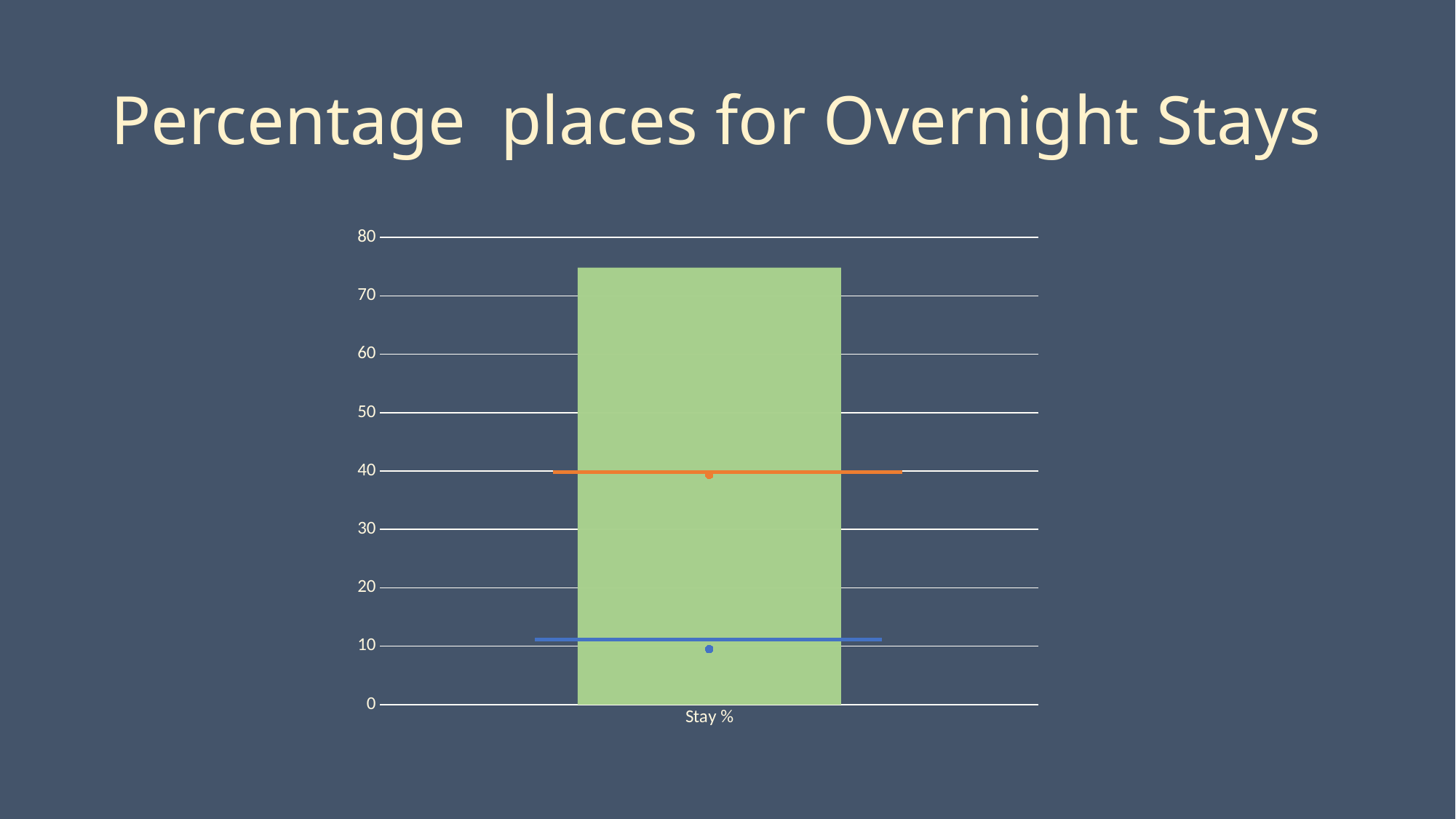
What is the label of the single category on the x axis? Stay % Is the value marked by the orange line greater or less than 30? greater Is the value of the green bar for Stay % greater or less than 80? less Which is lower on the chart: the orange line or the blue line? the blue line What kind of chart is shown on the slide? bar chart Which is higher on the chart: the top of the green bar or the orange line? the green bar What is the highest value shown on the vertical axis? 80 Is the value marked by the orange line greater or less than 50? less How many categories are shown on the x axis of the chart? 1 What is the title shown above the chart? Percentage places for Overnight Stays